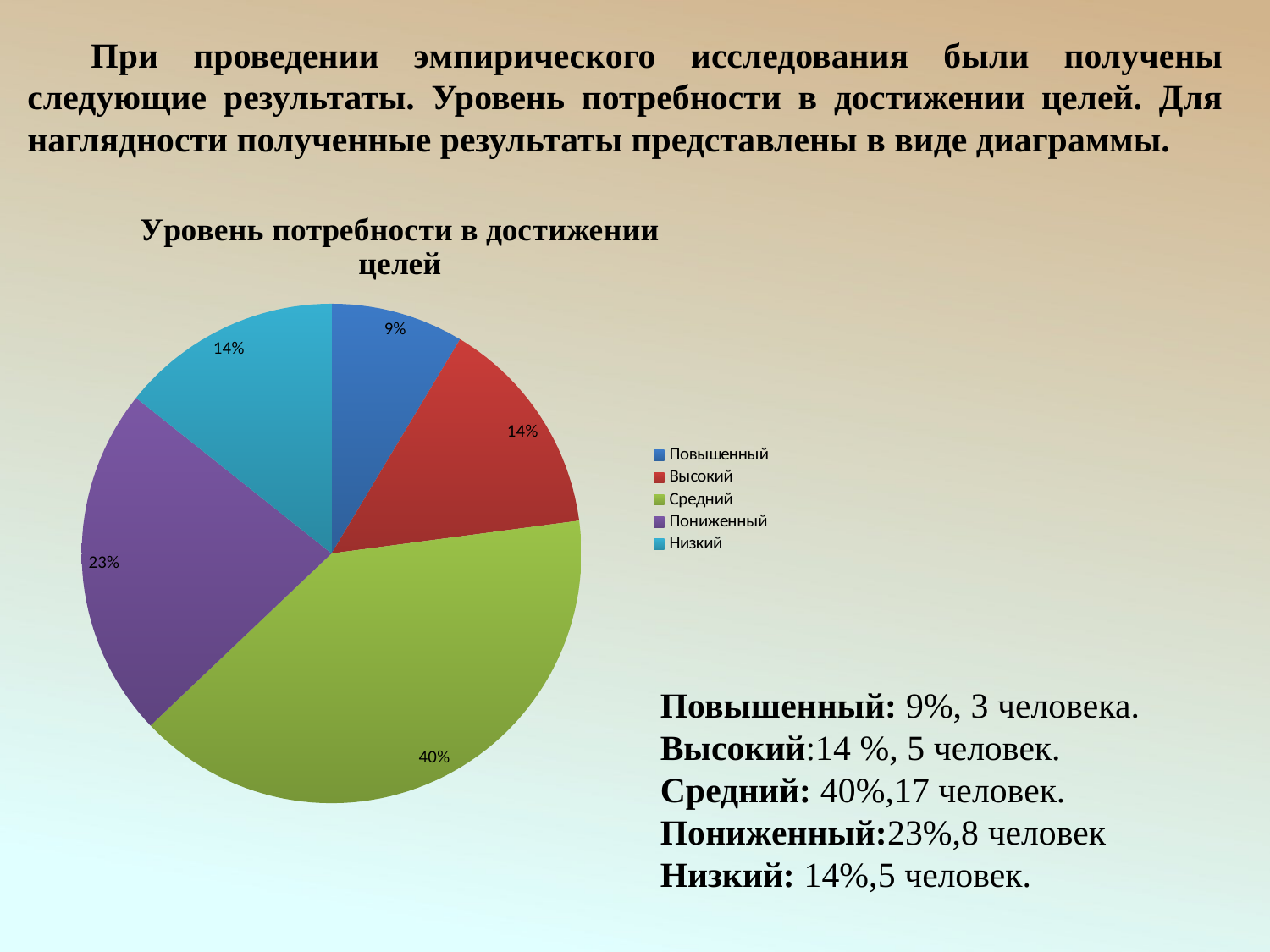
What is the value shown for the Повышенный slice? 9% What type of chart is shown on the slide? Pie chart What share of the pie does the Средний slice represent? 40% How many categories does the legend list? 5 Which category has the largest slice of the pie? Средний Which category has the smallest slice of the pie? Повышенный Which slice is larger, Пониженный or Низкий? Пониженный What is the value shown for the Пониженный slice? 23% What is the title of the chart? Уровень потребности в достижении целей How many slices does the pie chart have? 5 What is the difference in percentage points between the Средний and Пониженный slices? 17 What is the value shown for the Высокий slice? 14%